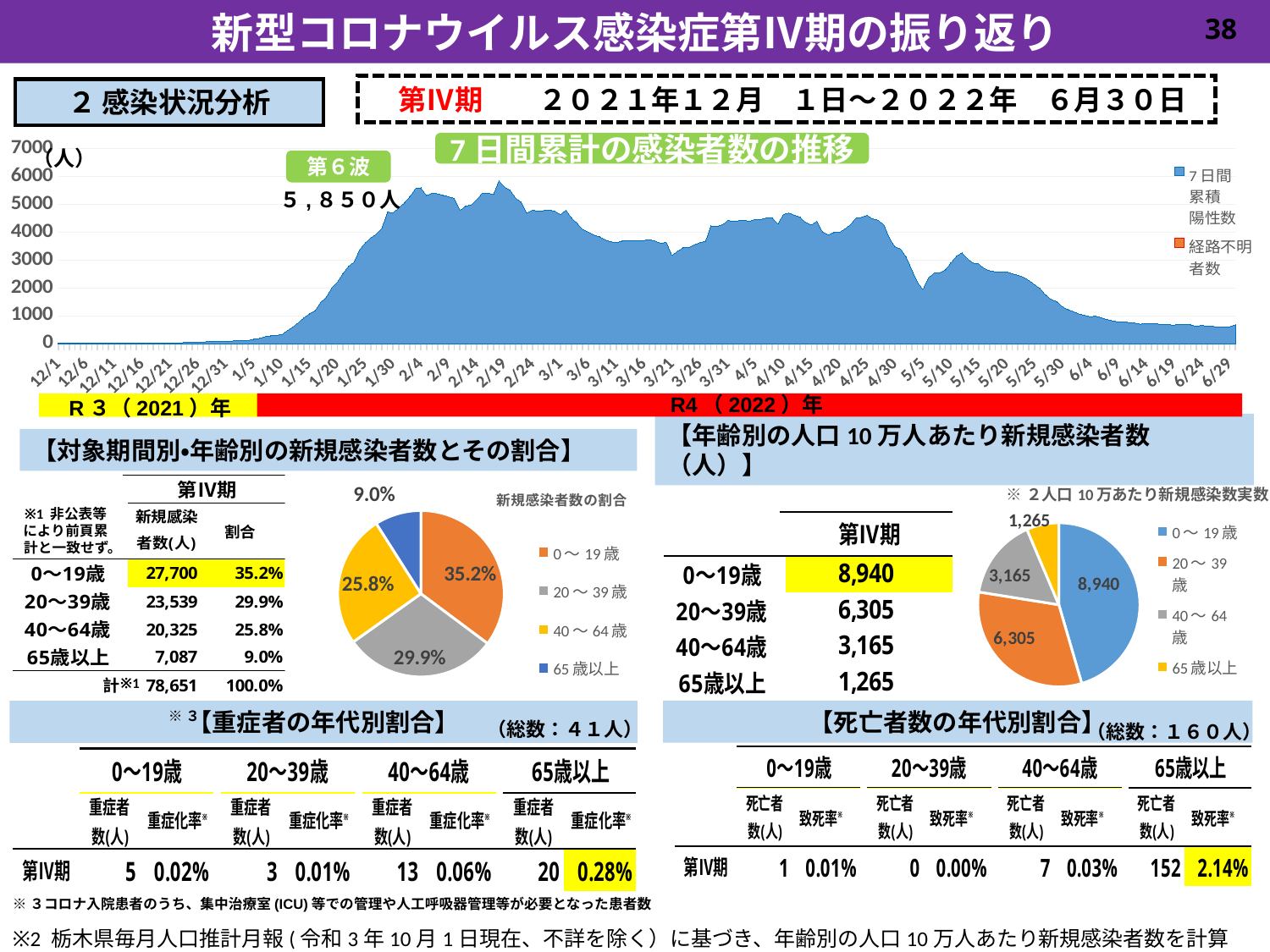
「7日間累計の感染者数の推移」のグラフはどの種類のグラフですか？ 面グラフ 「7日間累計の感染者数の推移」のグラフで、2/4の値は5000より大きいですか、小さいですか？ 大きい 「新規感染者数の割合」の円グラフで、最も割合が大きい年齢層はどれですか？ 0〜19歳 「新規感染者数の割合」の円グラフで、0〜19歳と65歳以上の割合の差は何ポイントですか？ 26.2ポイント 「7日間累計の感染者数の推移」のグラフの凡例には、いくつの系列が示されていますか？ 2 「新規感染者数の割合」の円グラフで、20〜39歳の割合はいくつですか？ 29.9% 「新規感染者数の割合」の円グラフで、最も割合が小さい年齢層はどれですか？ 65歳以上 「7日間累計の感染者数の推移」のグラフで、第6波のピークとして表示されている値はいくつですか？ 5,850人 「年齢別の人口10万人あたり新規感染者数」の円グラフで、40〜64歳と65歳以上ではどちらの値が大きいですか？ 40〜64歳 「年齢別の人口10万人あたり新規感染者数」の円グラフで、0〜19歳と20〜39歳の値の差はいくつですか？ 2,635 「7日間累計の感染者数の推移」のグラフで、6/29の値は1000より大きいですか、小さいですか？ 小さい 「年齢別の人口10万人あたり新規感染者数」の円グラフで、40〜64歳の値はいくつですか？ 3,165